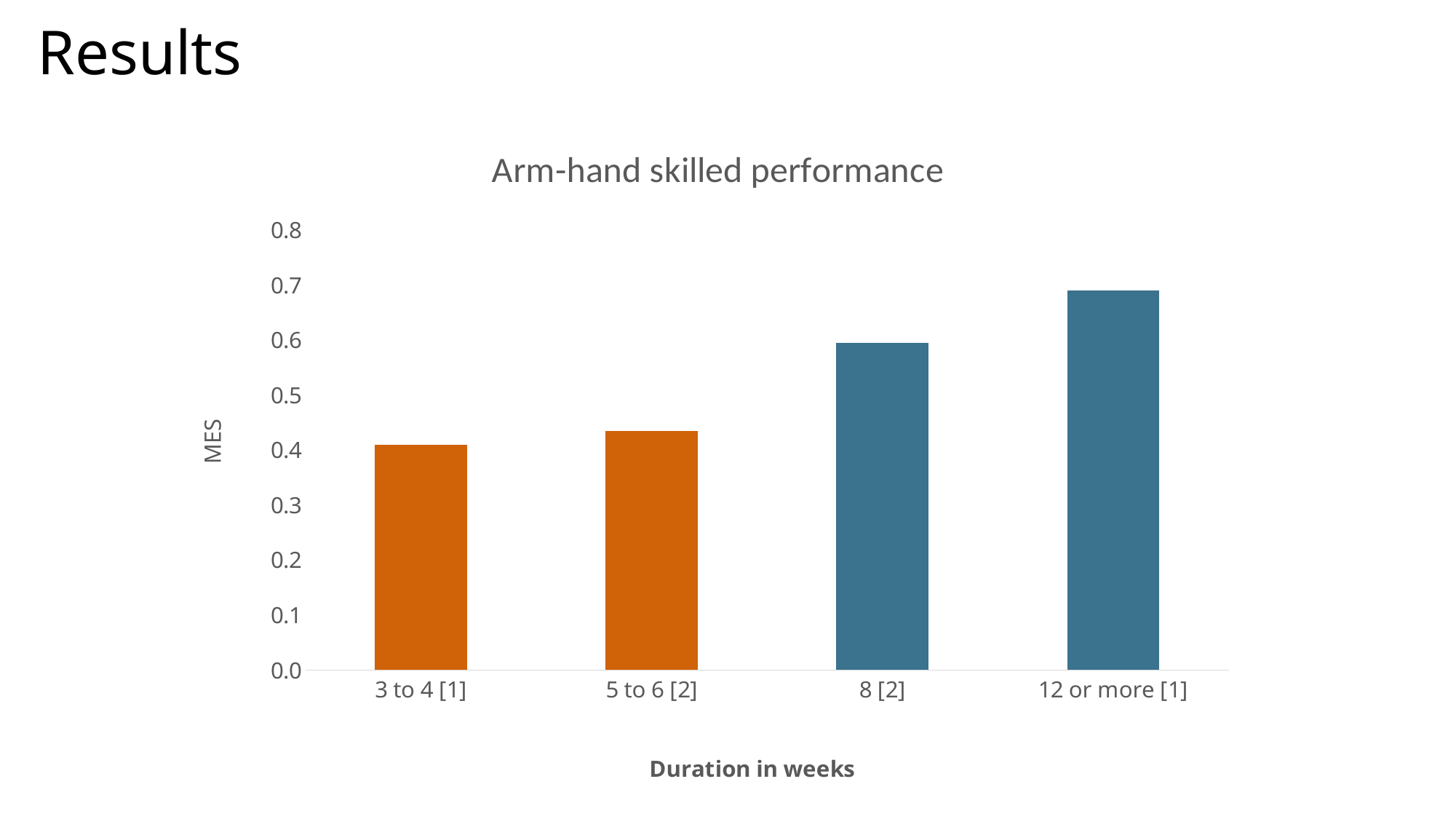
Is the MES value for 5 to 6 [2] greater or less than 0.5? less What type of chart is shown on the slide? Bar chart How many duration categories are plotted on the x axis? 4 Is the MES value for 12 or more [1] greater or less than 0.6? greater Is the MES value for 8 [2] greater or less than 0.5? greater What is the title of the chart? Arm-hand skilled performance Which has a larger MES value, 3 to 4 [1] or 12 or more [1]? 12 or more [1] Do the MES values rise or fall as the duration in weeks increases along the x axis? Rise Which has a larger MES value, 8 [2] or 5 to 6 [2]? 8 [2] Which duration category has the highest MES value? 12 or more [1] What is the label of the x axis? Duration in weeks